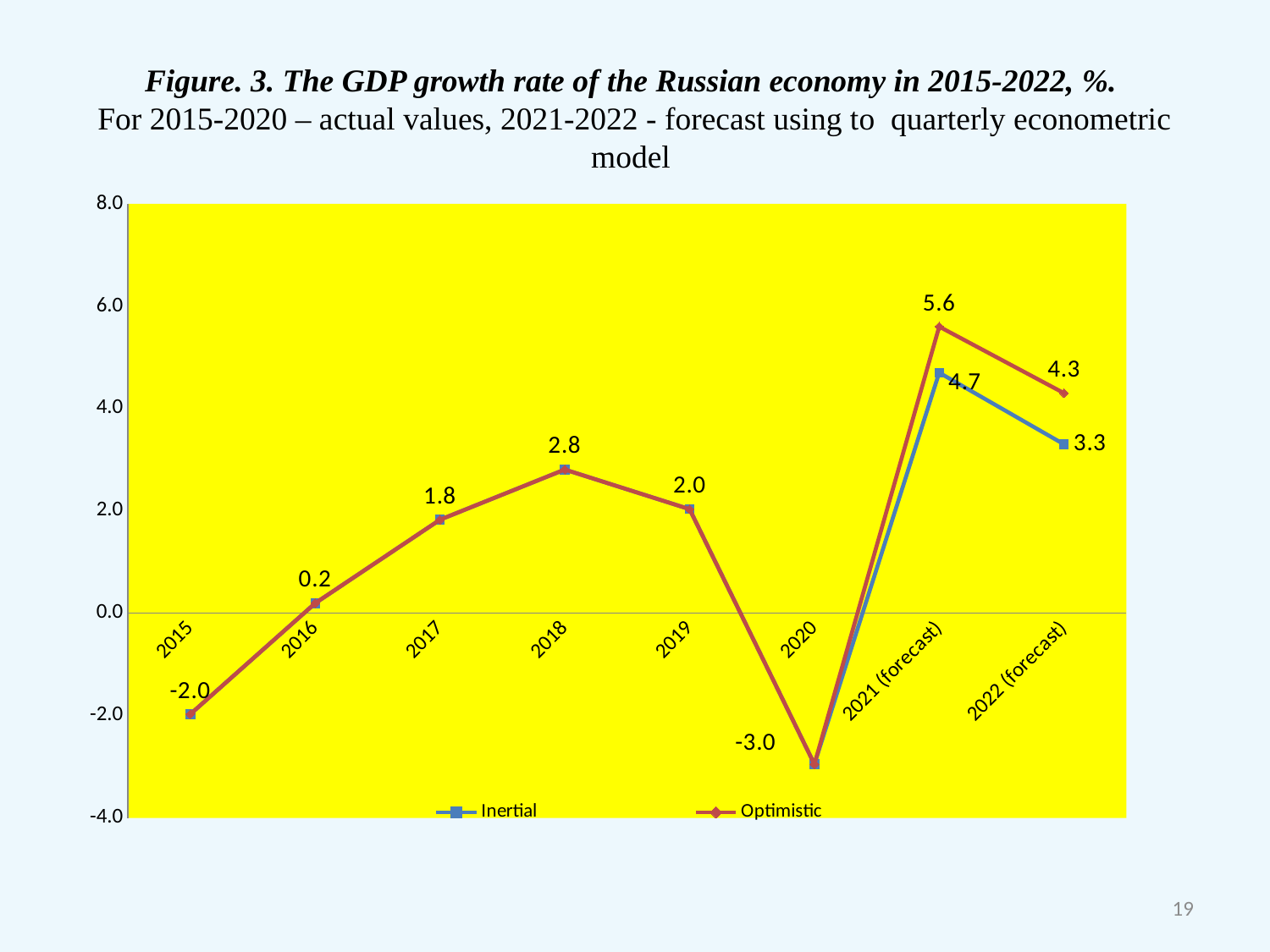
What is the difference between the Optimistic and Inertial values for 2022 (forecast)? 1.0 Which year has the highest value on the chart? 2021 (forecast) Do the values rise or fall from 2018 to 2020? fall What is the GDP growth rate value for 2020? -3.0 What is the Optimistic forecast value for 2021? 5.6 What is the GDP growth rate value for 2018? 2.8 How many years (categories) are plotted along the x axis? 8 Which year has the lowest GDP growth rate on the chart? 2020 What kind of chart is shown on the slide? line chart How many series does the legend list? 2 Which is larger, the value for 2017 or the value for 2019? 2019 What is the Inertial forecast value for 2022? 3.3